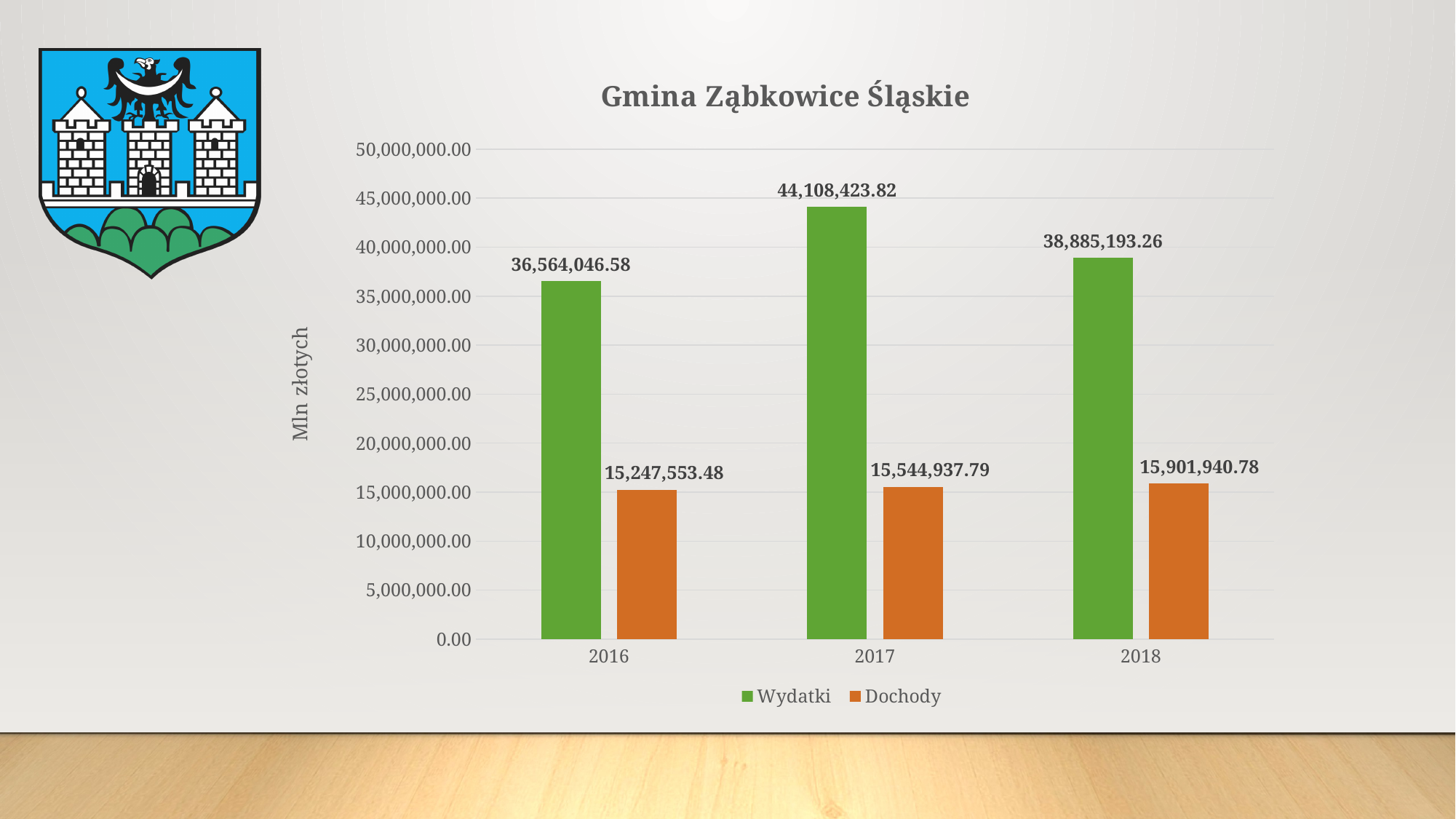
What is the difference between Wydatki and Dochody in 2017? 28,563,486.03 Is the Wydatki value for 2016 greater or less than 35,000,000.00? greater How many years are shown on the x axis? 3 In which year is Dochody lowest? 2016 What is the Wydatki value for 2017? 44,108,423.82 What kind of chart is shown on the slide? Bar chart By how much did Wydatki increase from 2016 to 2017? 7,544,377.24 What is the Dochody value for 2016? 15,247,553.48 How many series does the legend list? 2 In which year is Wydatki highest? 2017 What is the Wydatki value for 2018? 38,885,193.26 Which is larger in 2018, Wydatki or Dochody? Wydatki